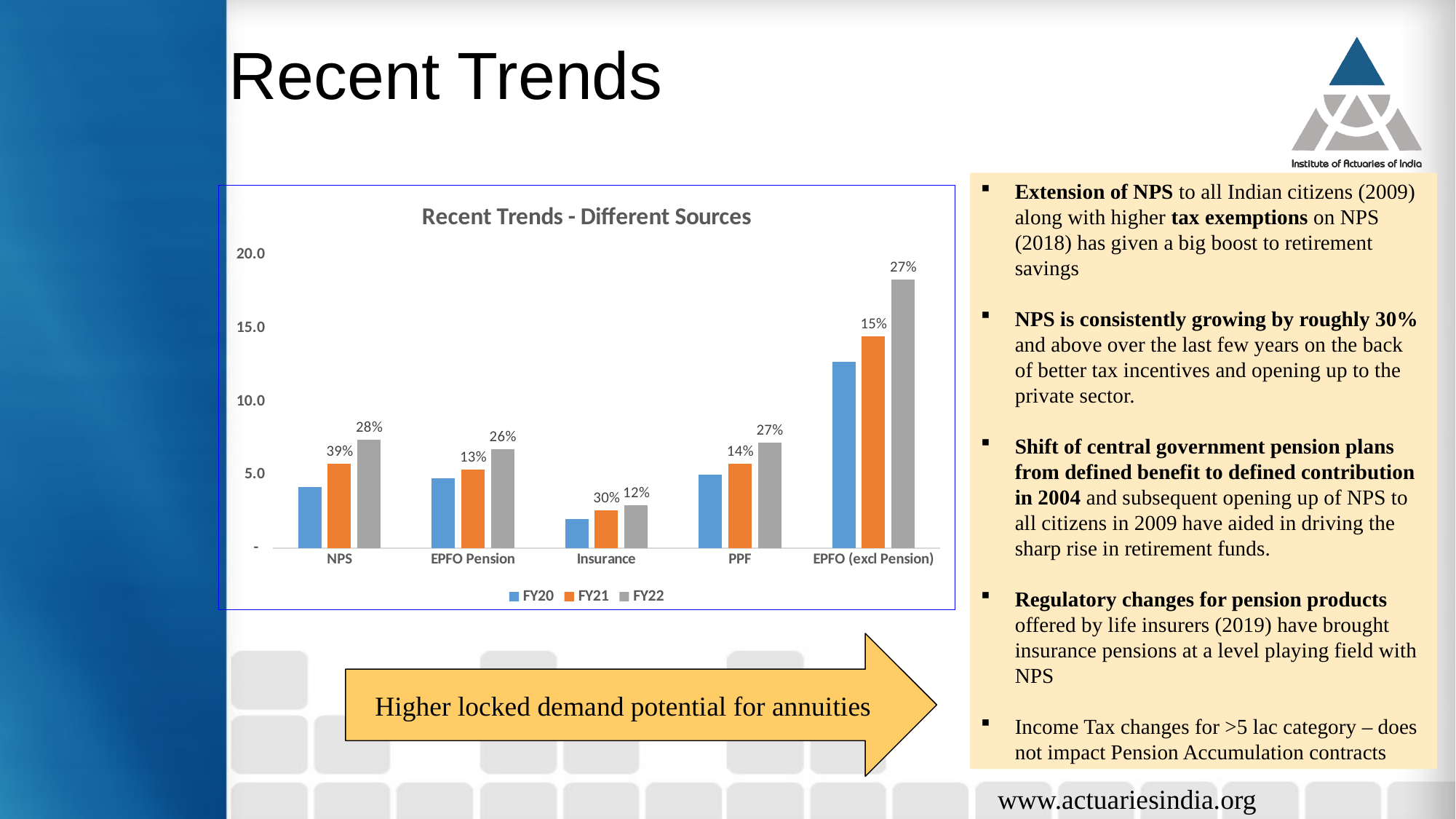
How many series does the chart legend list? 3 What percentage label is printed above the FY21 bar for Insurance? 30% What percentage label is printed above the FY22 bar for EPFO Pension? 26% What is the title of the chart? Recent Trends - Different Sources What type of chart is shown on the slide? bar chart How many categories are shown on the x axis of the chart? 5 What percentage label is printed above the FY21 bar for NPS? 39% Is the FY22 value for EPFO (excl Pension) greater or less than 15.0? greater Which category has the tallest bar in the chart? EPFO (excl Pension) Which is larger, the FY20 value for EPFO (excl Pension) or the FY20 value for NPS? EPFO (excl Pension) Is the FY20 value for Insurance greater or less than 5.0? less Which category has the shortest FY20 bar in the chart? Insurance